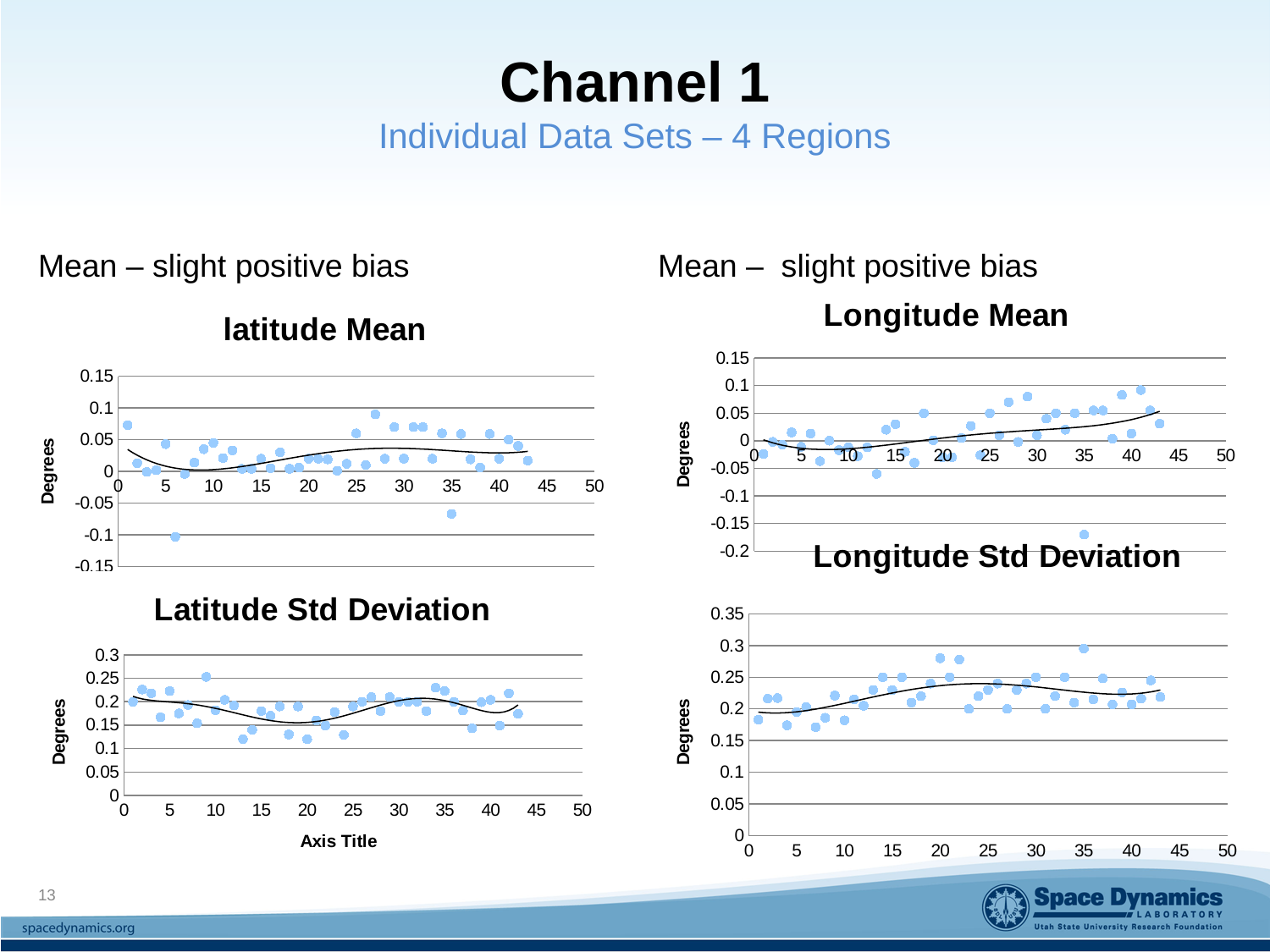
What kind of chart is the "latitude Mean" chart? scatter chart In the "Latitude Std Deviation" chart, is the lowest plotted point greater or less than 0.15? less In the "latitude Mean" chart, is the lowest plotted point greater or less than -0.05? less What is the y-axis title of the "Longitude Std Deviation" chart? Degrees In the "Longitude Std Deviation" chart, is the highest plotted point (near x = 35) greater or less than 0.25? greater In the "Longitude Std Deviation" chart, does the fitted trend line generally rise or fall from x = 0 to x = 45? rise How many charts are shown on the slide? 4 What is the maximum value shown on the y-axis of the "Longitude Std Deviation" chart? 0.35 What is the x-axis title shown on the "Latitude Std Deviation" chart? Axis Title In the "Longitude Mean" chart, does the fitted trend line generally rise or fall as x increases? rise